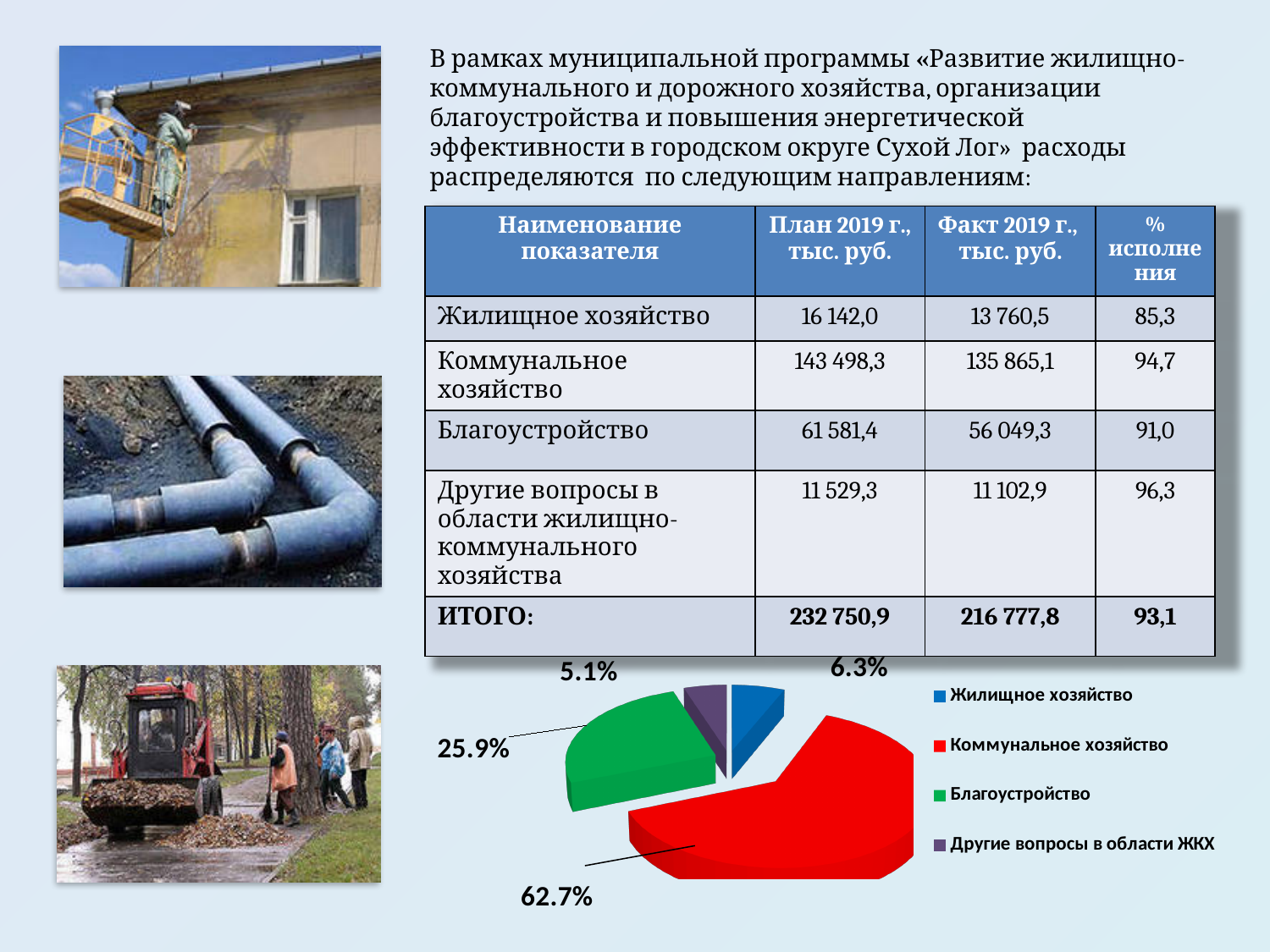
In the pie chart, which is larger: the slice for Благоустройство or the slice for Жилищное хозяйство? Благоустройство What share of the pie chart does Коммунальное хозяйство take? 62.7% What kind of chart is shown at the bottom of the slide? pie chart How many slices does the pie chart have? 4 What share of the pie chart does Благоустройство take? 25.9% How many entries does the pie chart's legend list? 4 What share of the pie chart does Другие вопросы в области ЖКХ take? 5.1% Which category has the smallest slice in the pie chart? Другие вопросы в области ЖКХ What colour is the Коммунальное хозяйство slice in the pie chart? red By how many percentage points does the Коммунальное хозяйство slice exceed the Благоустройство slice in the pie chart? 36.8 Which category has the largest slice in the pie chart? Коммунальное хозяйство